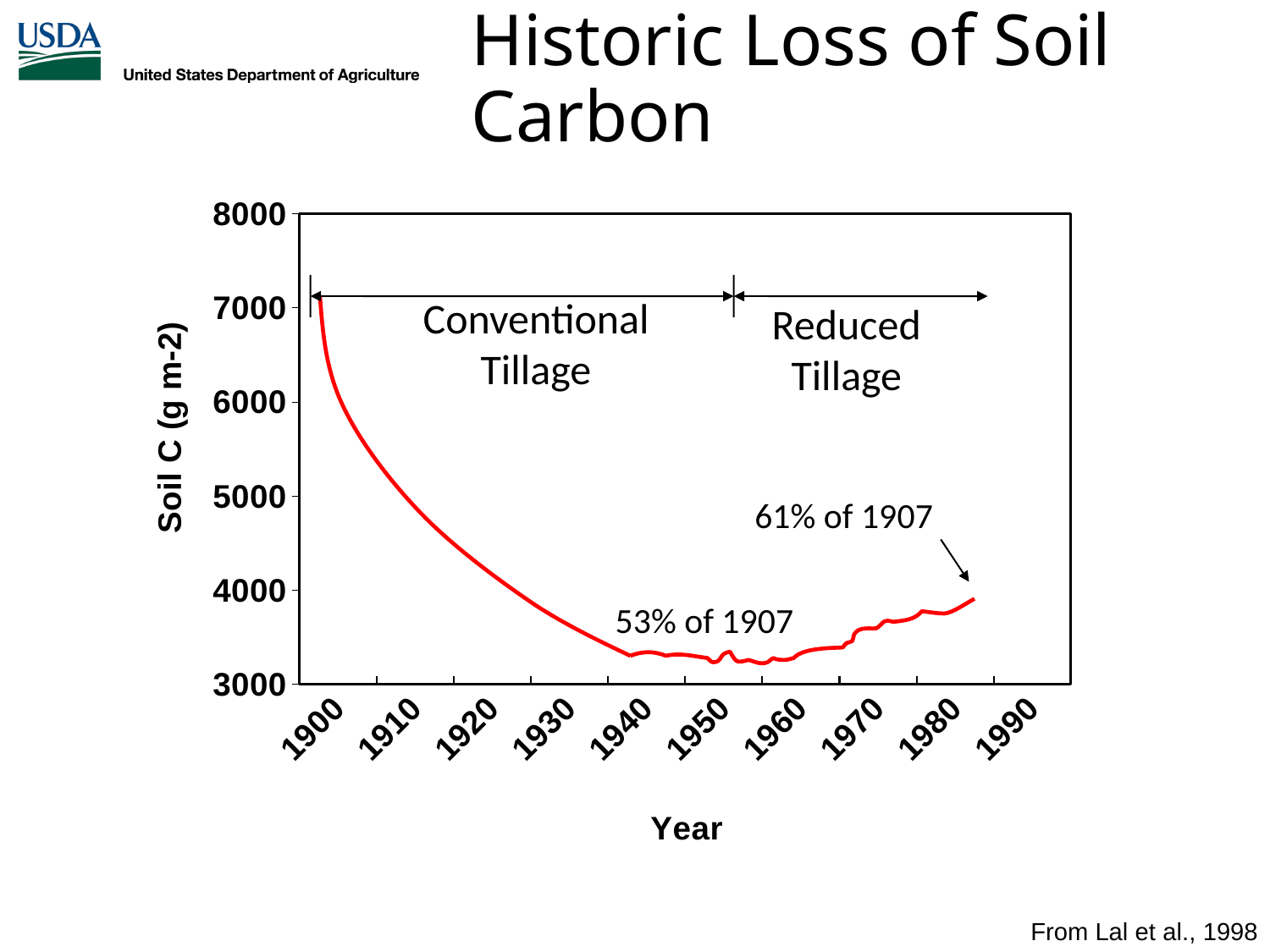
Does soil carbon rise or fall between 1900 and 1940? fall What kind of chart is shown on the slide? line chart What is the title of the chart on the slide? Historic Loss of Soil Carbon Does soil carbon rise or fall between 1960 and 1985? rise Is the soil carbon value in 1900 greater or less than 6000? greater According to the annotation, what percentage of the 1907 level is soil carbon at the end of the line around 1985? 61% of 1907 Is the soil carbon value in 1940 greater or less than 4000? less Is the soil carbon value in 1985 greater or less than 4000? less What is the label of the y axis? Soil C (g m-2) Which year has the higher soil carbon value, 1910 or 1930? 1910 According to the annotation, what percentage of the 1907 level is soil carbon at its lowest point around 1940? 53% of 1907